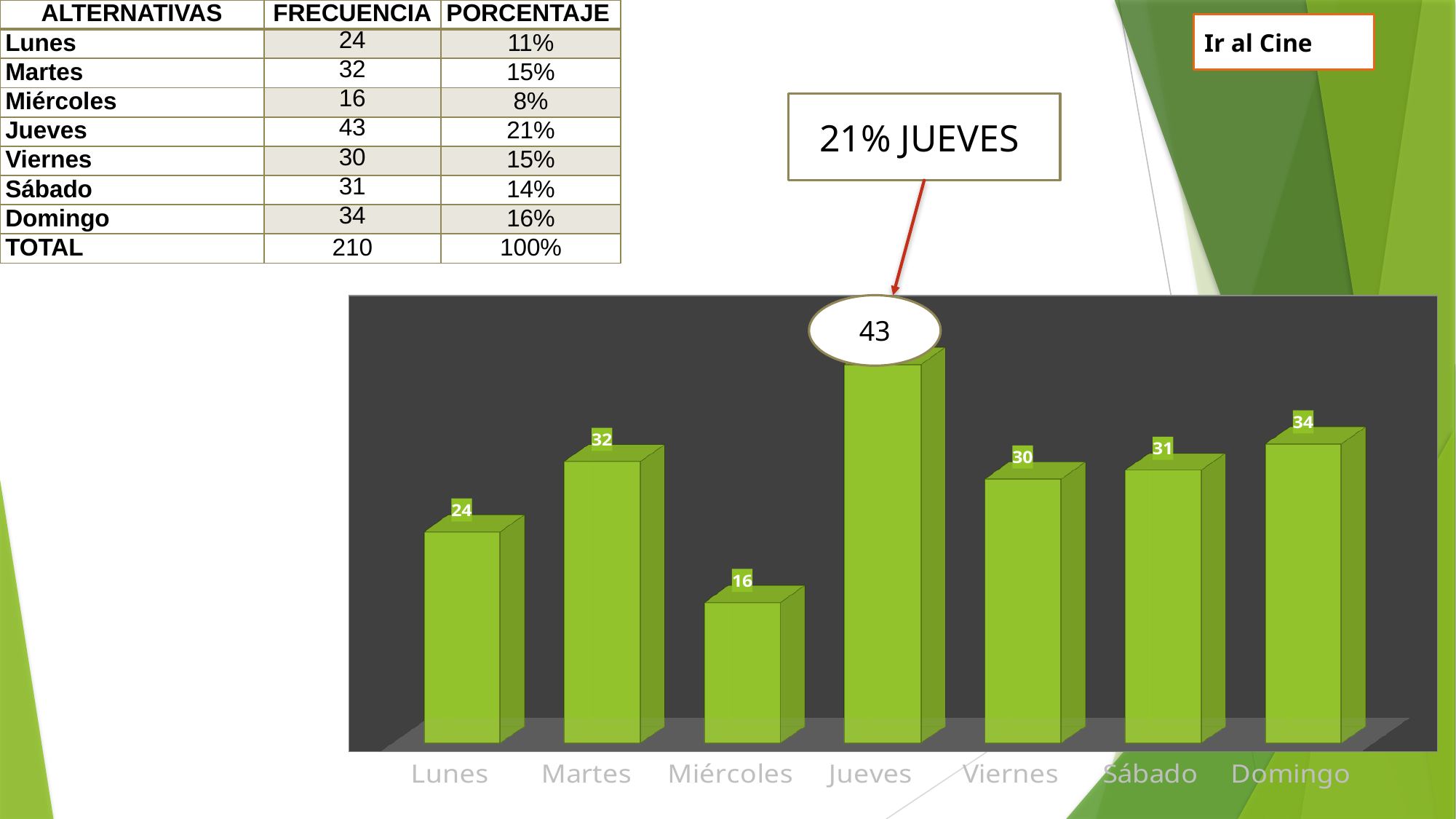
What is the value for Jueves in the bar chart? 43 What is the value for Domingo in the bar chart? 34 What is the value for Miércoles in the bar chart? 16 What text is shown in the callout box pointing to the tallest bar? 21% JUEVES What kind of chart is shown on the slide? bar chart Which is larger, the value for Martes or the value for Lunes? Martes Which is larger, the value for Domingo or the value for Viernes? Domingo Which day has the lowest value in the bar chart? Miércoles What is the difference between the values for Martes and Viernes? 2 What is the difference between the values for Jueves and Lunes? 19 How many categories are shown on the x axis of the bar chart? 7 Which day has the highest value in the bar chart? Jueves